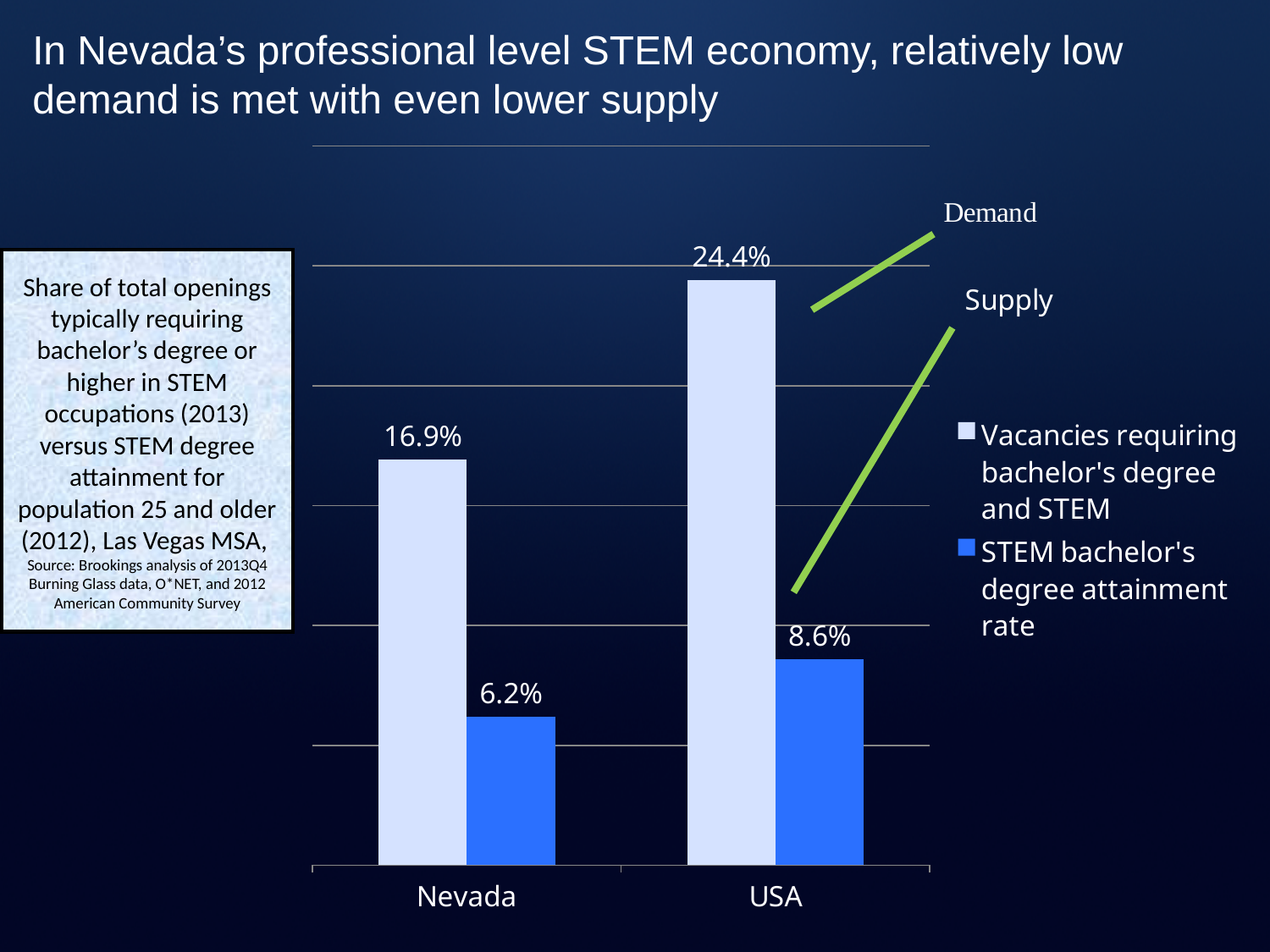
Which category has the highest value for Vacancies requiring bachelor's degree and STEM? USA What kind of chart is shown on the slide? Bar chart How many categories are shown on the x axis? 2 What is the value for Vacancies requiring bachelor's degree and STEM in the USA? 24.4% What is the difference between the USA and Nevada values for Vacancies requiring bachelor's degree and STEM? 7.5 percentage points Which is larger for the USA: Vacancies requiring bachelor's degree and STEM or the STEM bachelor's degree attainment rate? Vacancies requiring bachelor's degree and STEM What is the STEM bachelor's degree attainment rate for Nevada? 6.2% Which category has the lowest STEM bachelor's degree attainment rate? Nevada What is the value for Vacancies requiring bachelor's degree and STEM in Nevada? 16.9% What is the difference between the Vacancies requiring bachelor's degree and STEM value and the STEM bachelor's degree attainment rate for Nevada? 10.7 percentage points How many series does the legend list? 2 What is the STEM bachelor's degree attainment rate for the USA? 8.6%